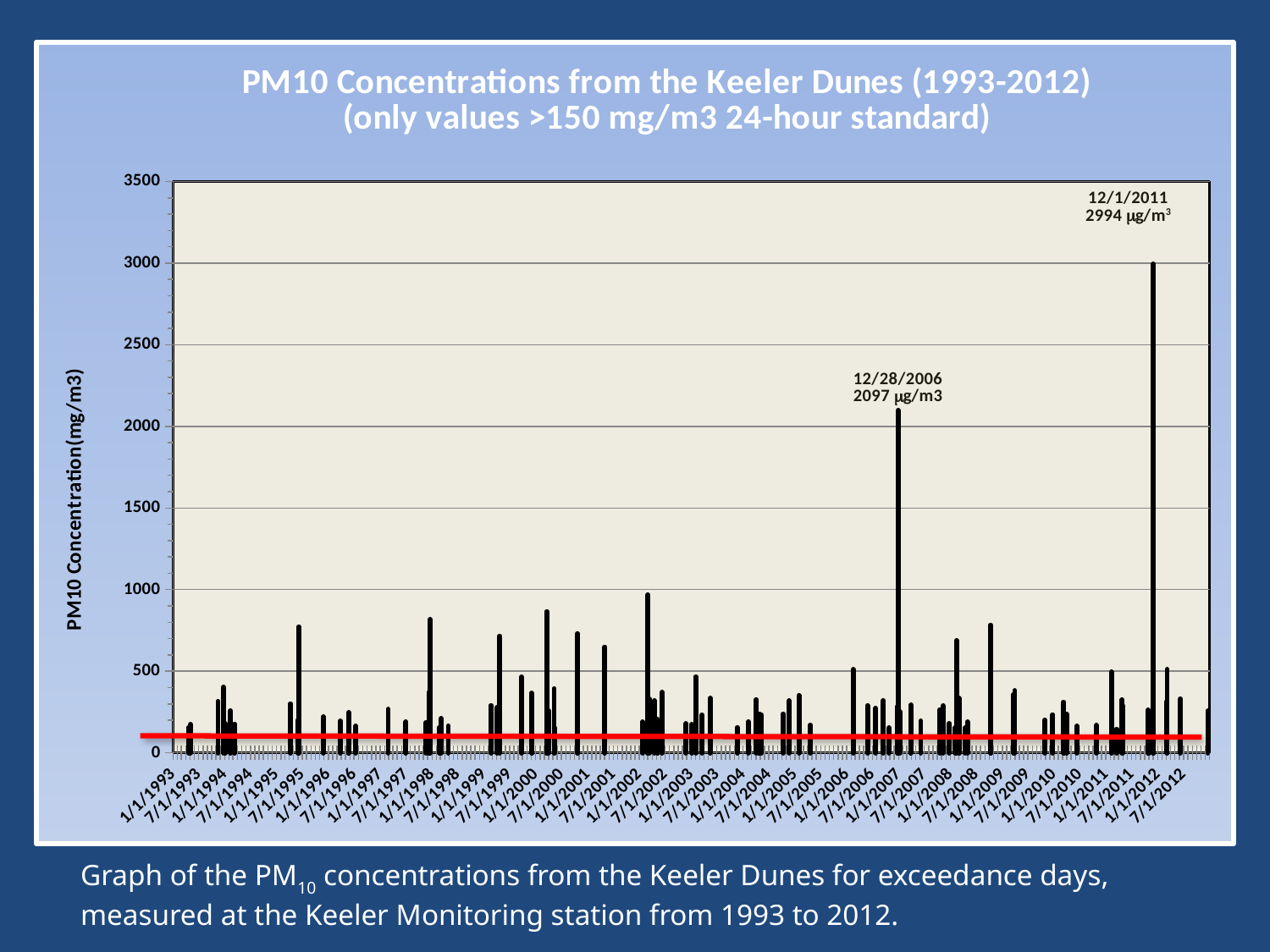
Is the value for 12/1/2011 greater or less than 2500? greater What PM10 concentration is labeled for 12/28/2006? 2097 µg/m3 What is the title of the chart? PM10 Concentrations from the Keeler Dunes (1993-2012) (only values >150 mg/m3 24-hour standard) What is the label on the vertical axis of the chart? PM10 Concentration (mg/m3) What PM10 concentration is labeled for 12/1/2011? 2994 µg/m³ Is the value for 12/28/2006 greater or less than 2000? greater What kind of chart is shown on the slide? Bar chart What is the difference between the labeled values for 12/1/2011 and 12/28/2006? 897 µg/m³ Apart from the two labeled peaks, is any bar greater or less than 1000? less Which date has the larger labeled PM10 concentration, 12/1/2011 or 12/28/2006? 12/1/2011 On which date does the chart show the highest PM10 concentration? 12/1/2011